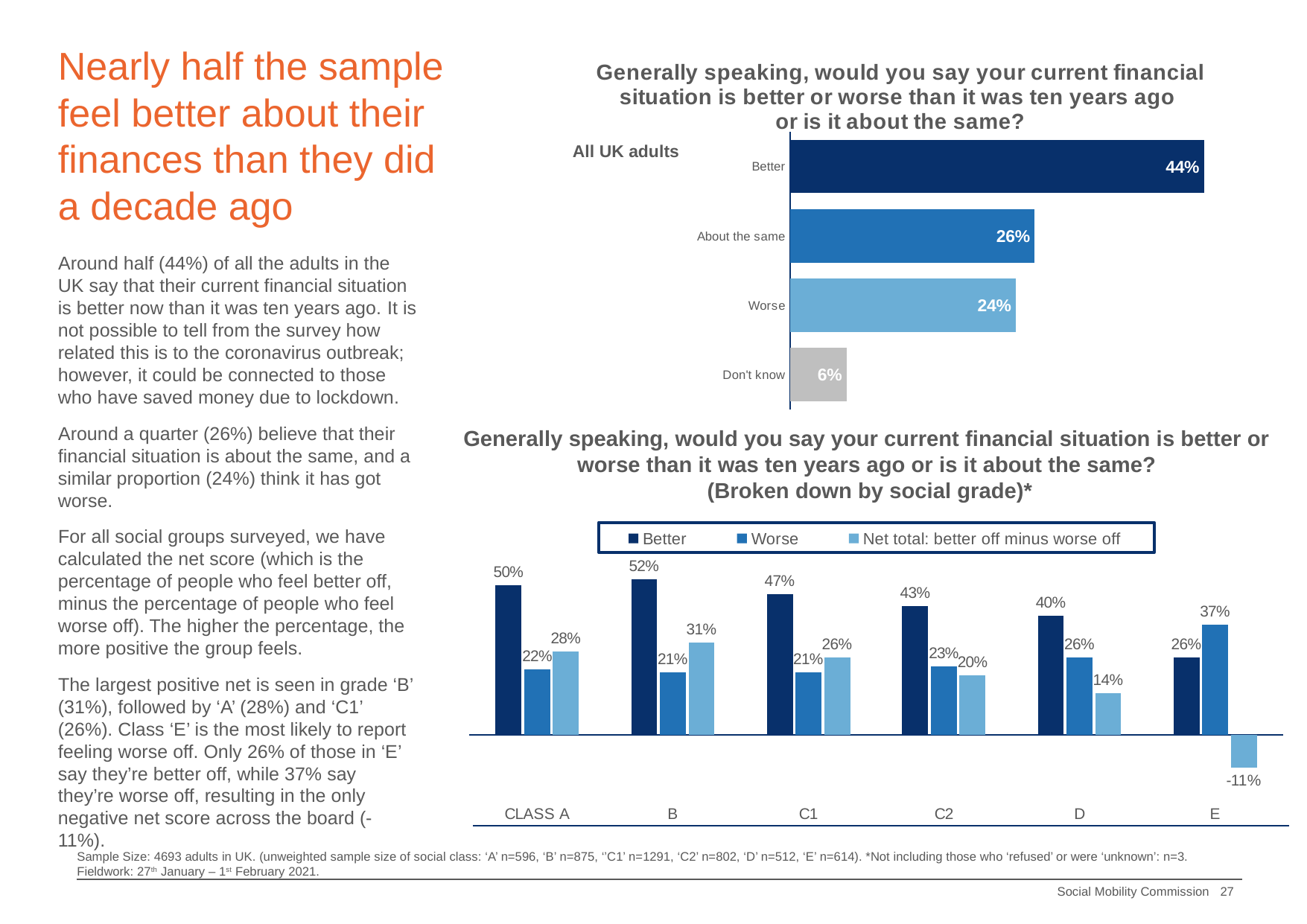
In the top chart (All UK adults), what percentage say their financial situation is better than ten years ago? 44% In the bottom chart (broken down by social grade), what is the difference between the 'Better' values for class A and class E? 24% In the top chart (All UK adults), what is the difference between 'About the same' and 'Worse'? 2% In the bottom chart (broken down by social grade), what is the net total for class E? -11% In the bottom chart (broken down by social grade), which class has the highest 'Worse' value? E In the top chart (All UK adults), which response has the lowest value? Don't know In the top chart (All UK adults), how many response categories are shown? 4 In the bottom chart (broken down by social grade), which is larger for class D: 'Better' or 'Worse'? Better In the bottom chart (broken down by social grade), do the 'Better' values rise or fall from class A to class E? Fall What type of chart is the top chart (All UK adults)? Bar chart In the bottom chart (broken down by social grade), what is the 'Better' value for class B? 52% How many series does the legend of the bottom chart (broken down by social grade) list? 3